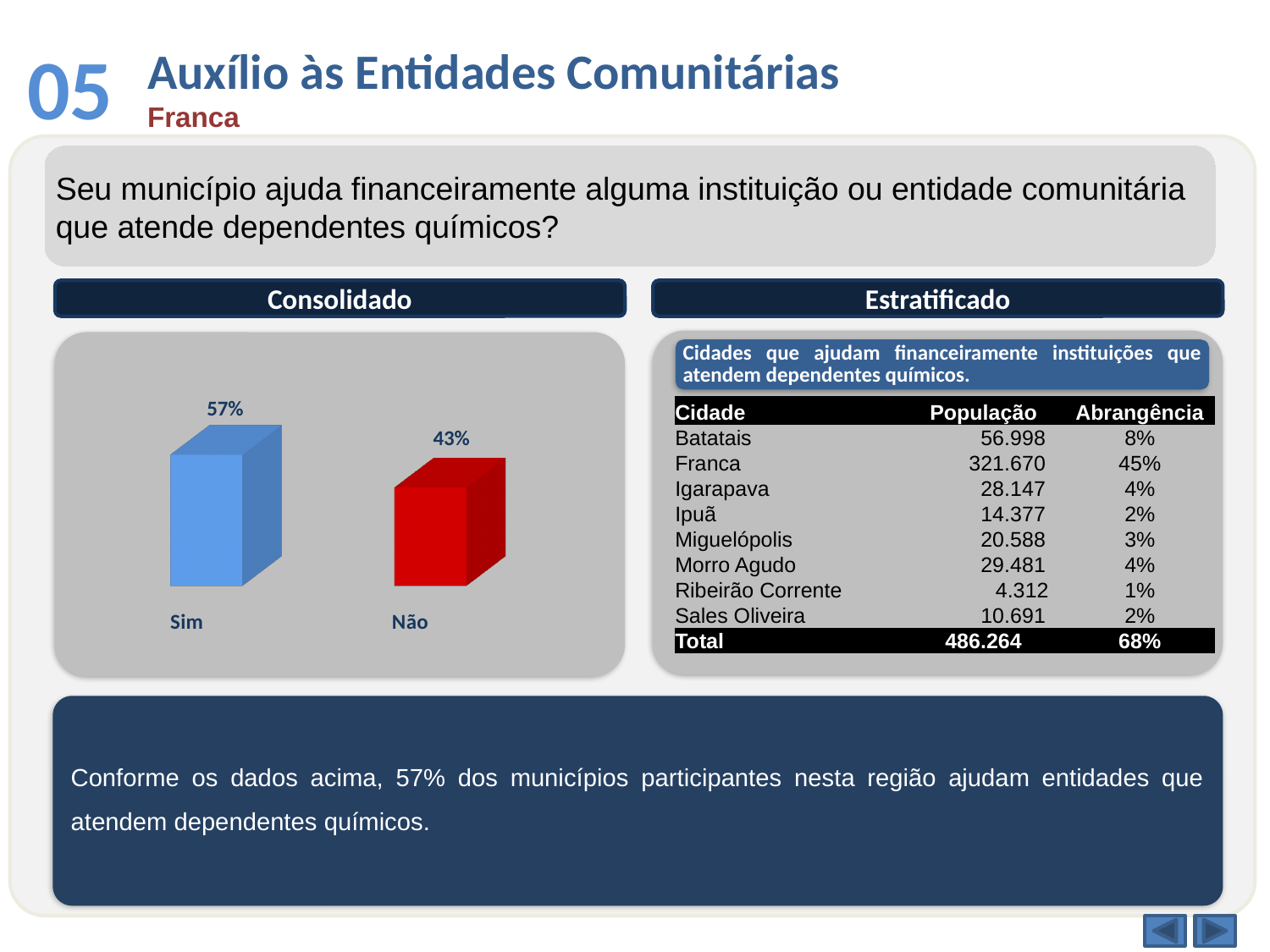
Which category has the lowest value in the Consolidado chart? Não In the Consolidado chart, which is larger: "Sim" or "Não"? Sim Which category has the highest value in the Consolidado chart? Sim What colour is the "Não" bar in the Consolidado chart? Red What colour is the "Sim" bar in the Consolidado chart? Blue What is the value for "Sim" in the Consolidado chart? 57% What is the total of the two values shown in the Consolidado chart? 100% What is the difference between the values for "Sim" and "Não" in the Consolidado chart? 14% What is the value for "Não" in the Consolidado chart? 43% What kind of chart is shown under "Consolidado"? Bar chart How many categories are shown in the Consolidado chart? 2